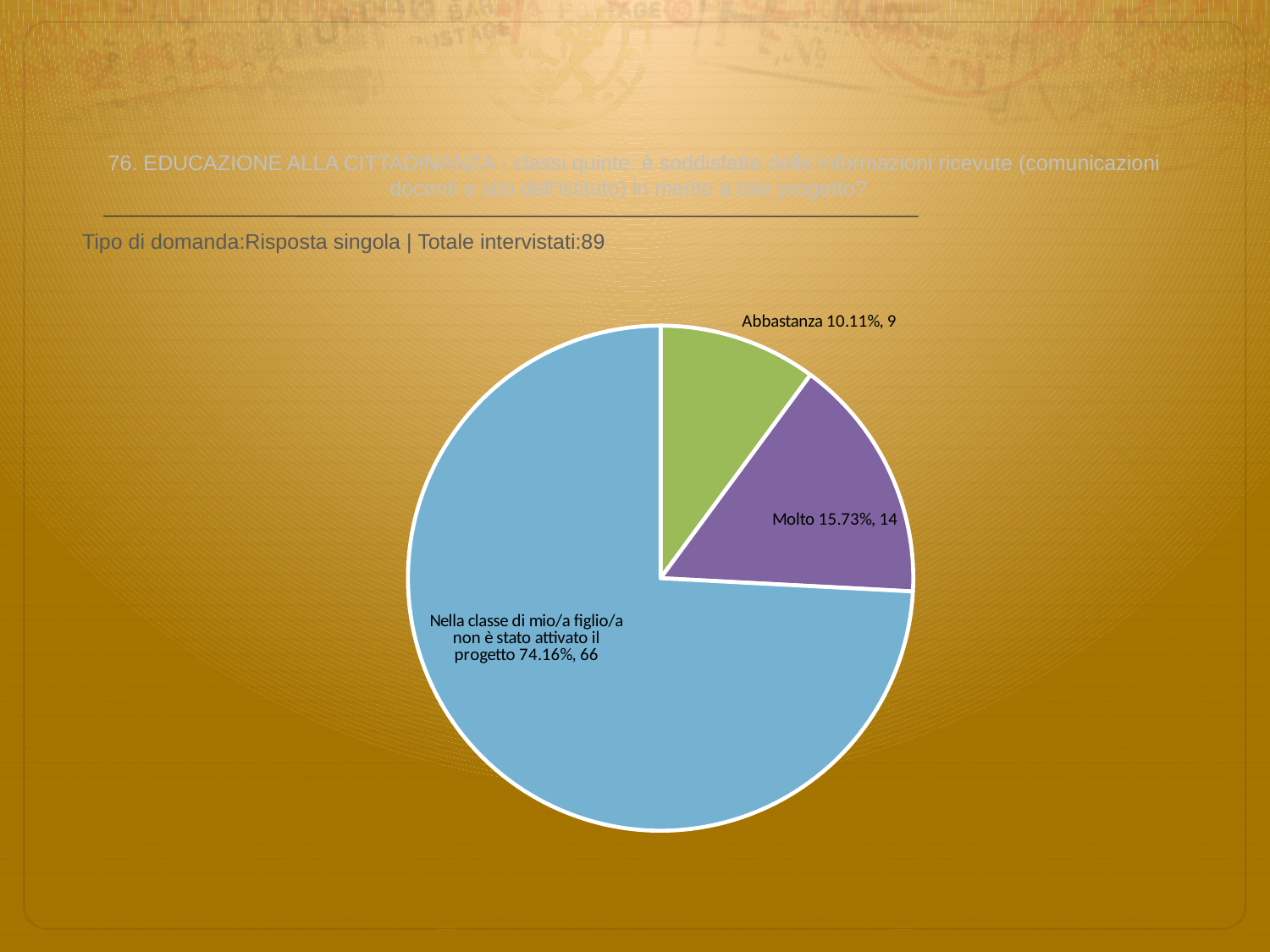
Which is larger, the "Molto" slice or the "Abbastanza" slice? Molto How many slices does the pie chart have? 3 What colour is the "Molto" slice? purple What percentage is shown for the "Nella classe di mio/a figlio/a non è stato attivato il progetto" slice? 74.16% What count is shown for the "Abbastanza" slice? 9 What is the total number of respondents stated on the slide? 89 Which slice is the largest? Nella classe di mio/a figlio/a non è stato attivato il progetto What count is shown for the "Molto" slice? 14 What kind of chart is shown on the slide? pie chart What percentage is shown for the "Abbastanza" slice? 10.11% Which slice is the smallest? Abbastanza What is the difference in count between the "Molto" slice and the "Abbastanza" slice? 5